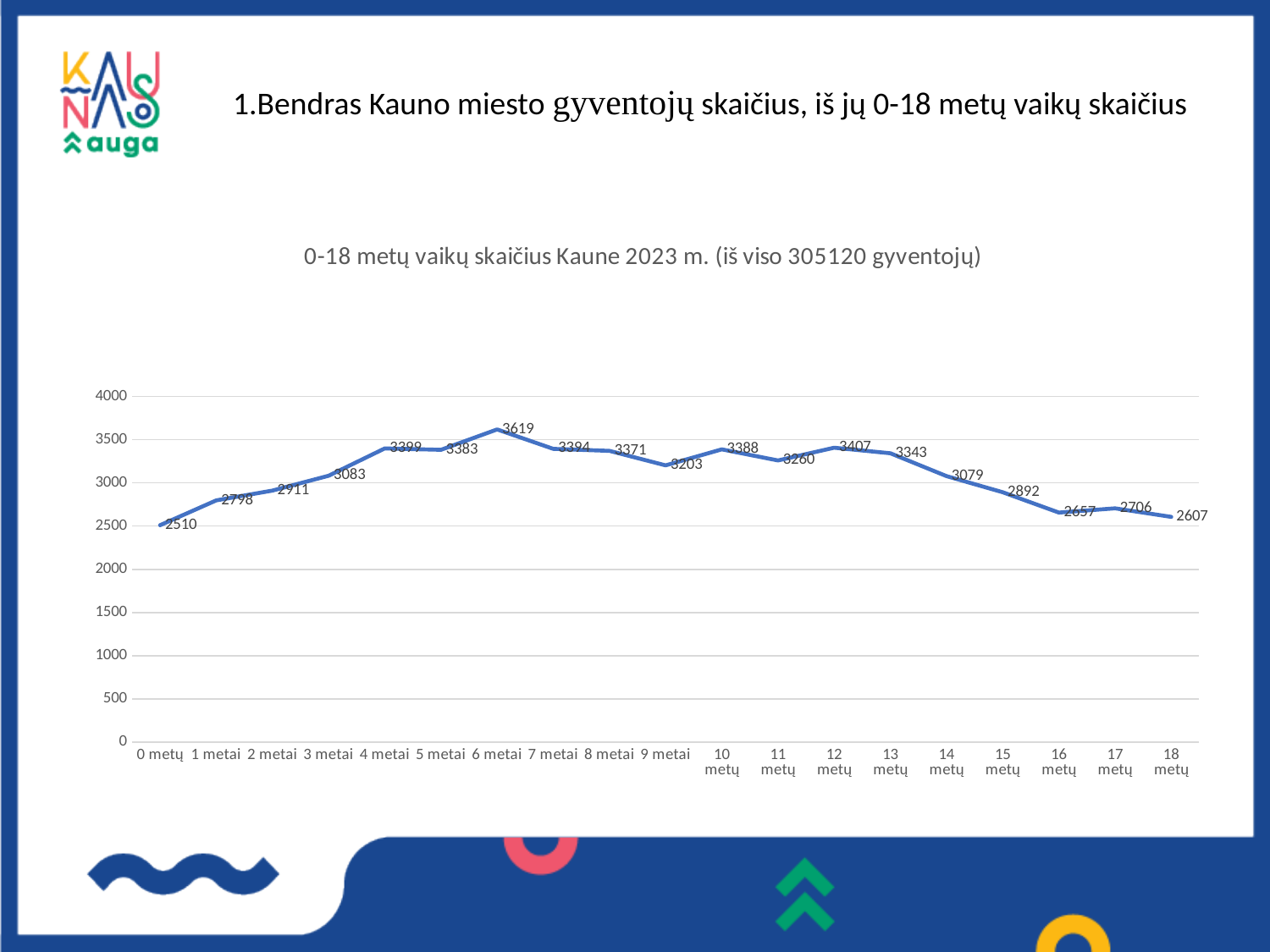
What is the value for 6 metai? 3619 Is the value for 18 metų greater or less than 3000? less How many age categories are plotted on the x axis? 19 Which age category has the lowest value? 0 metų What is the value for 15 metų? 2892 What is the difference between the values for 6 metai and 0 metų? 1109 What is the title of the chart? 0-18 metų vaikų skaičius Kaune 2023 m. (iš viso 305120 gyventojų) What is the value for 0 metų? 2510 What kind of chart is shown on the slide? line chart What is the value for 12 metų? 3407 Which age category has the highest value? 6 metai Which is larger, the value for 3 metai or the value for 14 metų? 3 metai